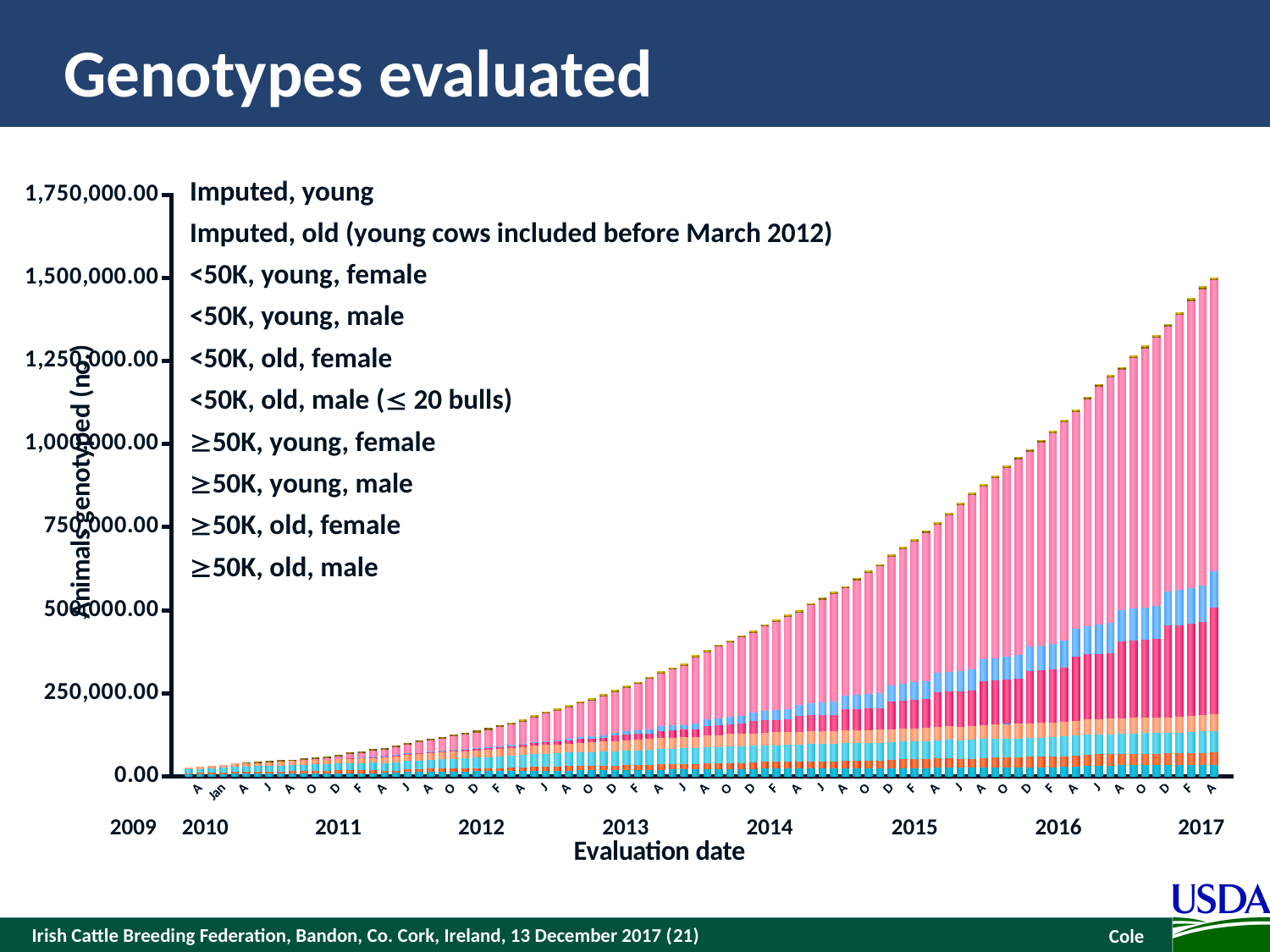
Which year on the x axis has the tallest bars? 2017 How many years are labeled along the x axis? 9 Is the total for the last bar (2017) greater or less than 1,250,000.00? greater Do the total bar heights rise or fall from 2009 to 2017? rise How many series does the legend list? 10 Is the total for the bar at the start of 2014 greater or less than 500,000.00? less What kind of chart is shown on the slide? stacked bar chart What is the title of the x axis? Evaluation date Is the total for the bar at the start of 2015 greater or less than 500,000.00? greater Which legend entry mentions March 2012? Imputed, old (young cows included before March 2012) Which year on the x axis has the shortest bars? 2009